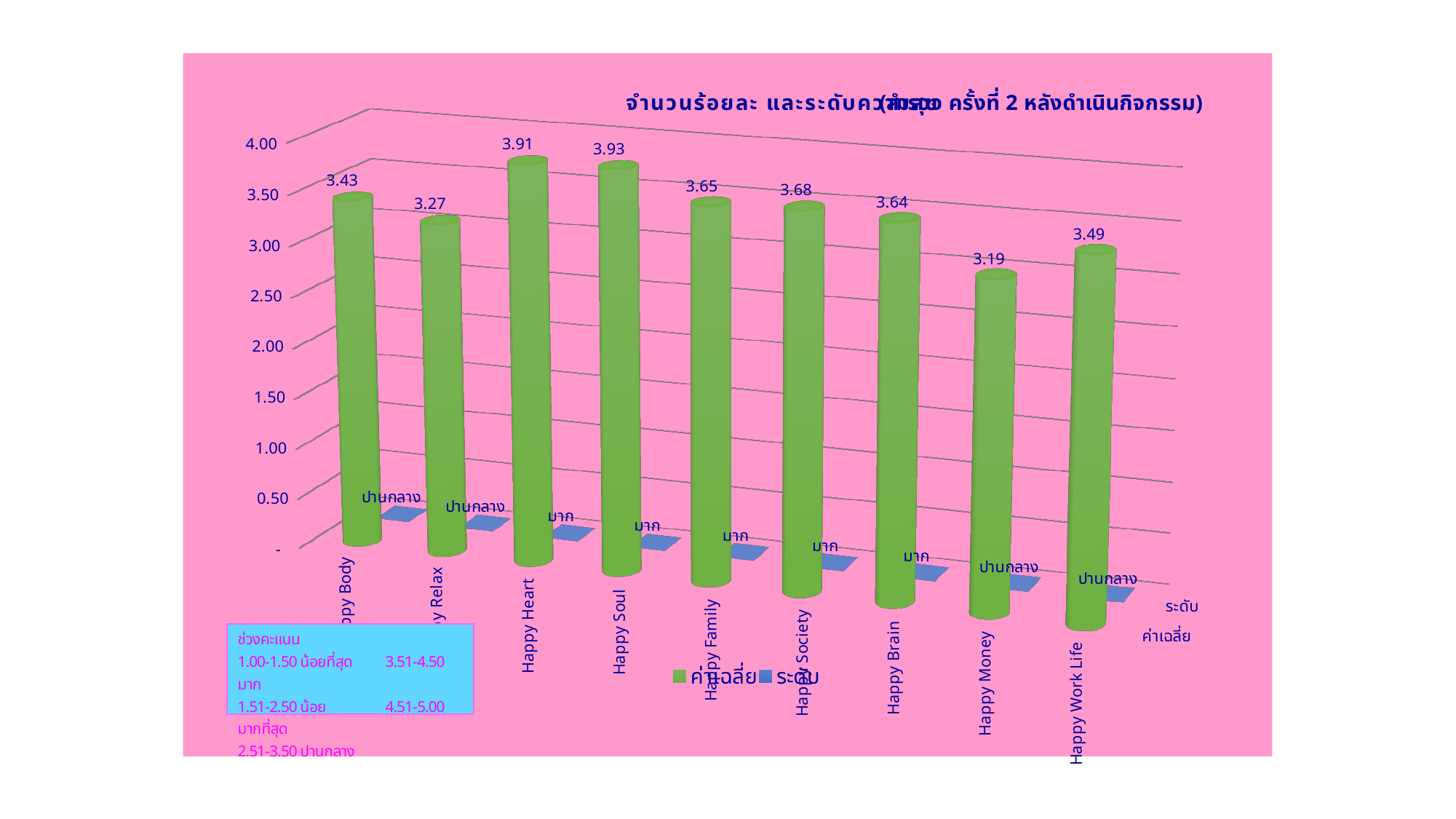
What level (ระดับ) label is shown for Happy Money? ปานกลาง How many series does the legend list? 2 Which category has the highest average value? Happy Soul How many categories are shown on the x axis? 9 What is the difference between the average values for Happy Soul and Happy Money? 0.74 Which has a larger average value, Happy Brain or Happy Money? Happy Brain What is the average value shown for Happy Money? 3.19 What level (ระดับ) label is shown for Happy Heart? มาก Which category has the lowest average value? Happy Money Is the average value for Happy Heart greater or less than 3.50? greater What is the average (ค่าเฉลี่ย) value for Happy Soul? 3.93 What is the average value shown for Happy Work Life? 3.49